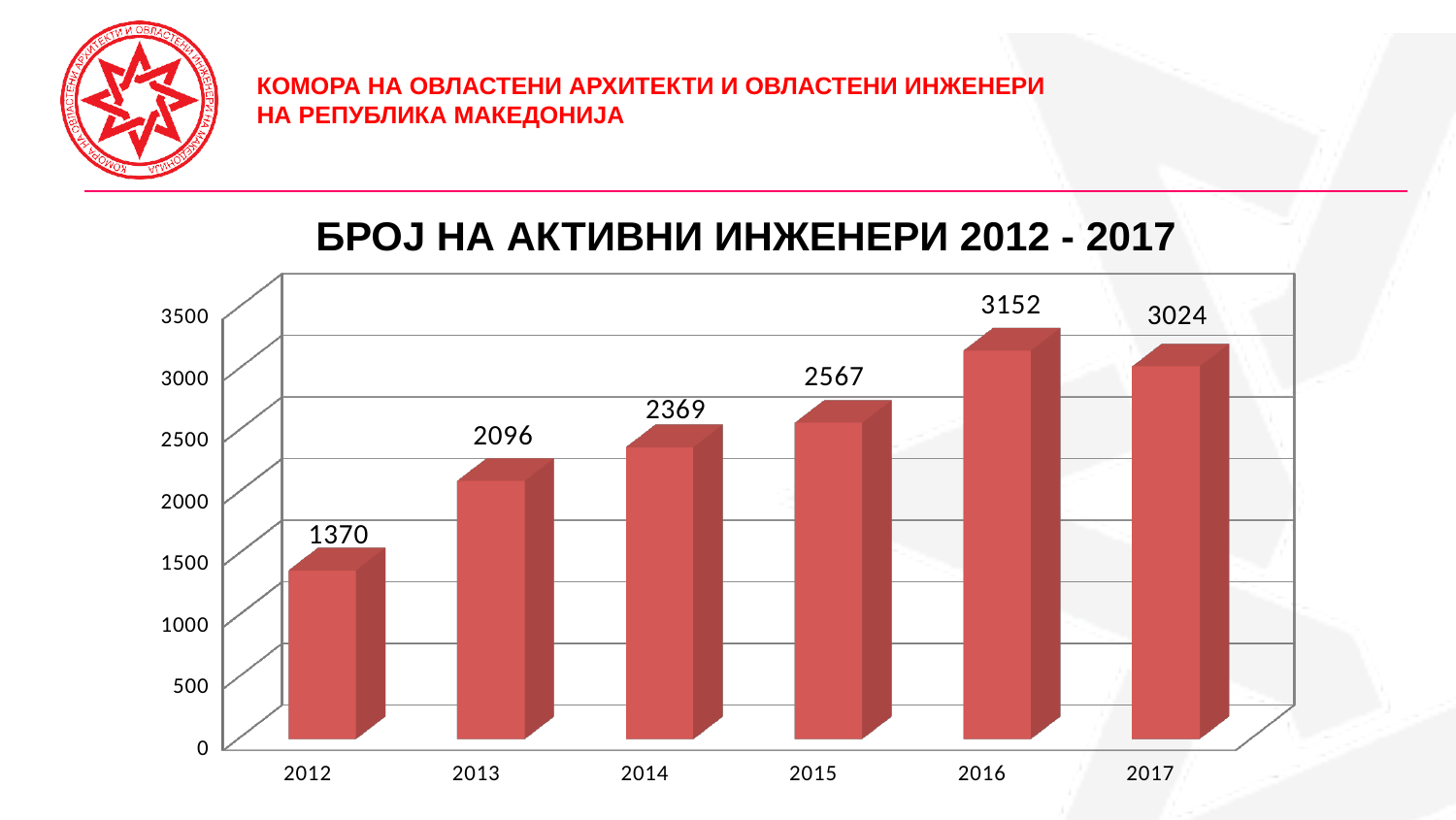
How many years are shown on the chart? 6 What kind of chart is shown on the slide? bar chart Which year has the highest number of active engineers? 2016 What is the number of active engineers in 2012? 1370 What is the number of active engineers in 2017? 3024 What is the number of active engineers in 2015? 2567 Which year has the lowest number of active engineers? 2012 What is the difference between the number of active engineers in 2013 and in 2012? 726 Is the value for 2014 greater or less than 2500? less Which year has more active engineers, 2014 or 2015? 2015 What is the title of the chart? БРОЈ НА АКТИВНИ ИНЖЕНЕРИ 2012 - 2017 What is the difference between the number of active engineers in 2016 and in 2017? 128